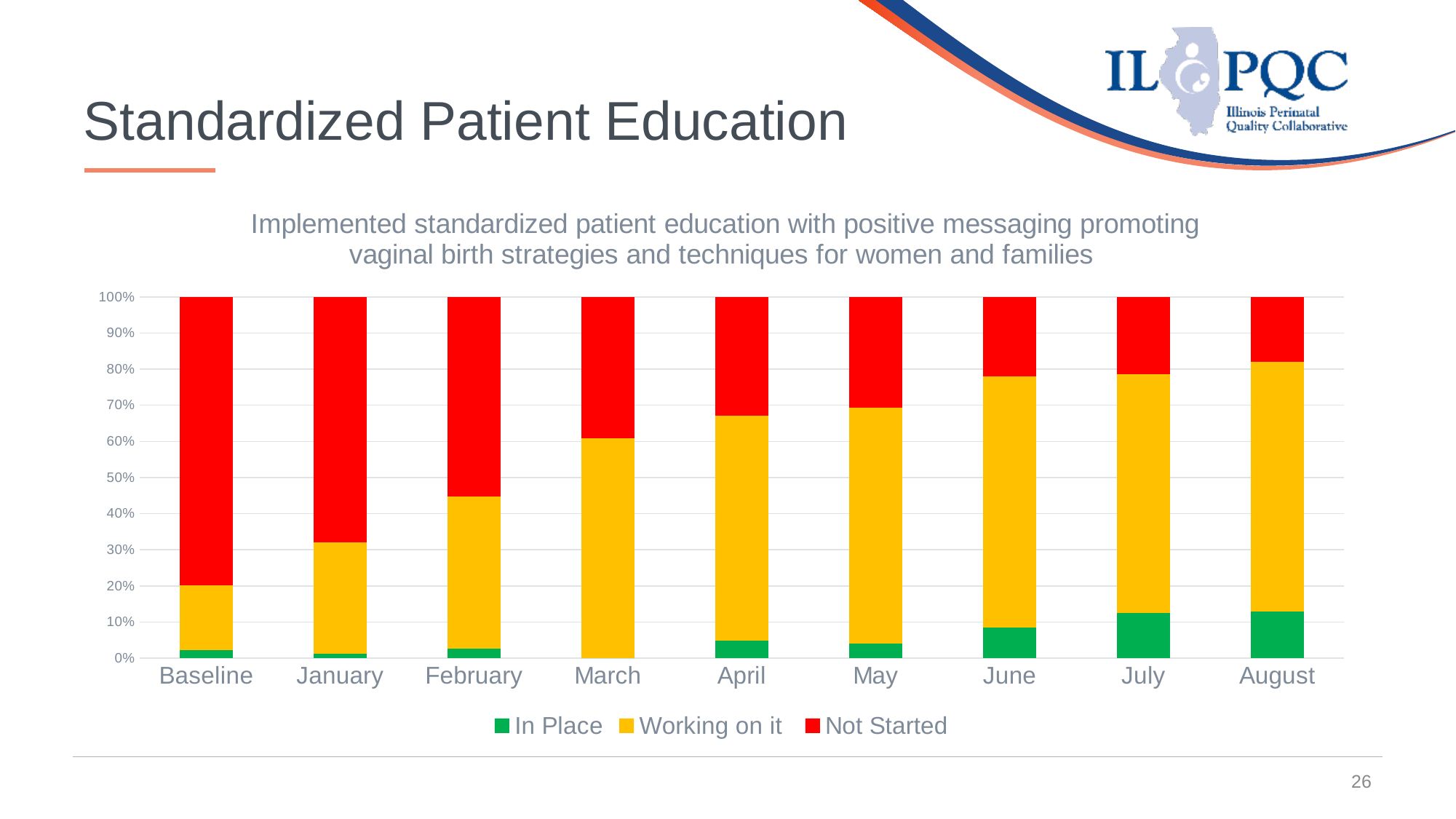
Which series is shown in red in the chart? Not Started Which category has the highest Not Started value? Baseline Is the Not Started value for August greater or less than 30%? less How many series does the chart legend list? 3 Is the Working on it value for March greater or less than 50%? greater Does the Not Started share rise or fall from Baseline to August? fall How many categories are shown along the x axis of the chart? 9 Is the Not Started value for Baseline greater or less than 70%? greater What is the first category on the x axis of the chart? Baseline What kind of chart is shown on the slide? Stacked bar chart Which category has the lowest Working on it value? Baseline